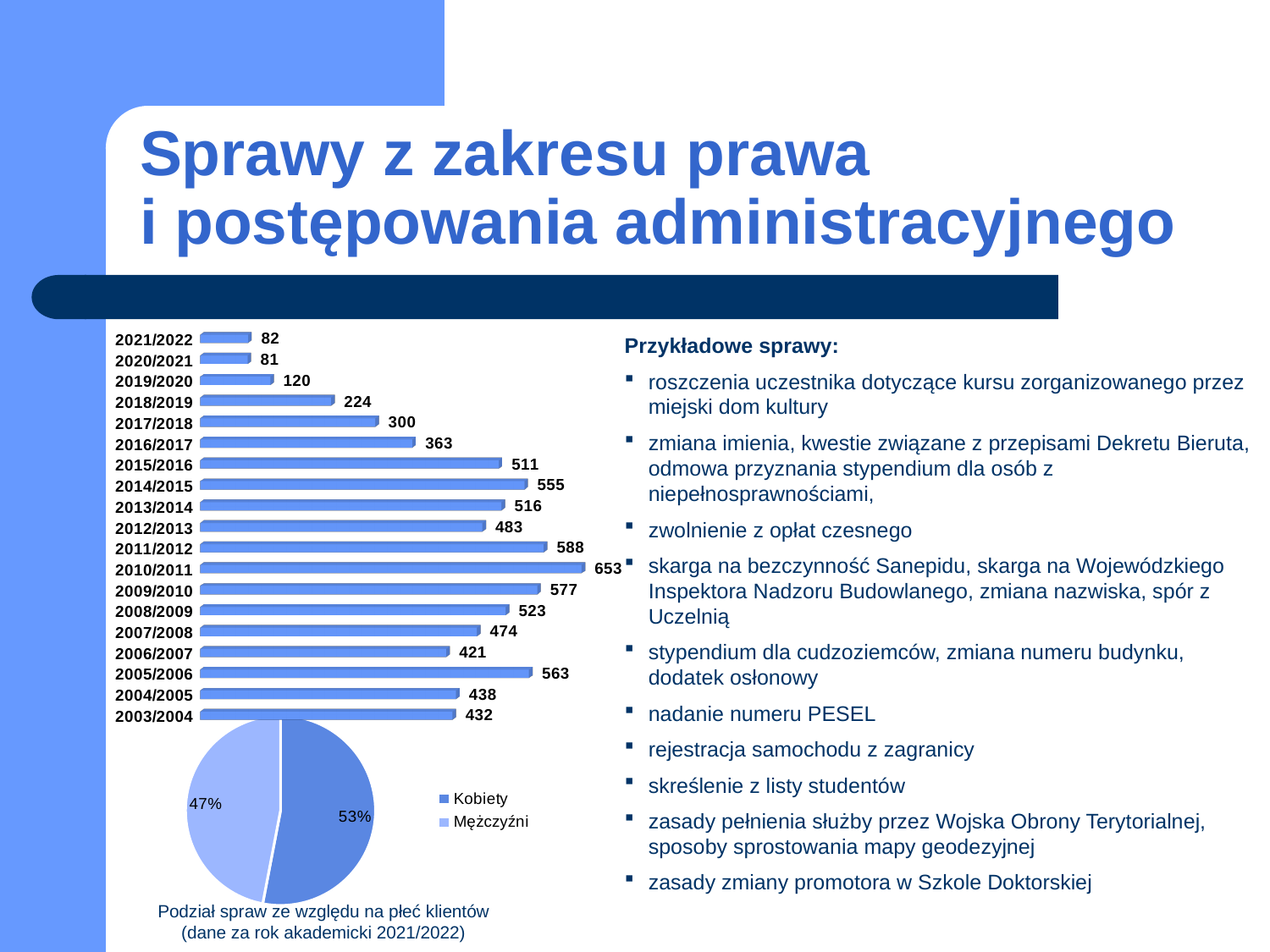
In the pie chart, what share is shown for Mężczyźni? 47% In the bar chart, what is the difference between the values for 2011/2012 and 2012/2013? 105 In the bar chart, what is the value for 2003/2004? 432 How many entries does the legend of the pie chart list? 2 In the bar chart, which academic year has the highest value? 2010/2011 What kind of chart is the chart showing values by academic year? bar chart In the pie chart, what share is shown for Kobiety? 53% How many academic years are shown in the bar chart? 19 In the bar chart, what is the value for 2019/2020? 120 In the bar chart, which is larger: the value for 2005/2006 or the value for 2014/2015? 2005/2006 In the bar chart, what is the value for 2010/2011? 653 In the bar chart, which academic year has the lowest value? 2020/2021